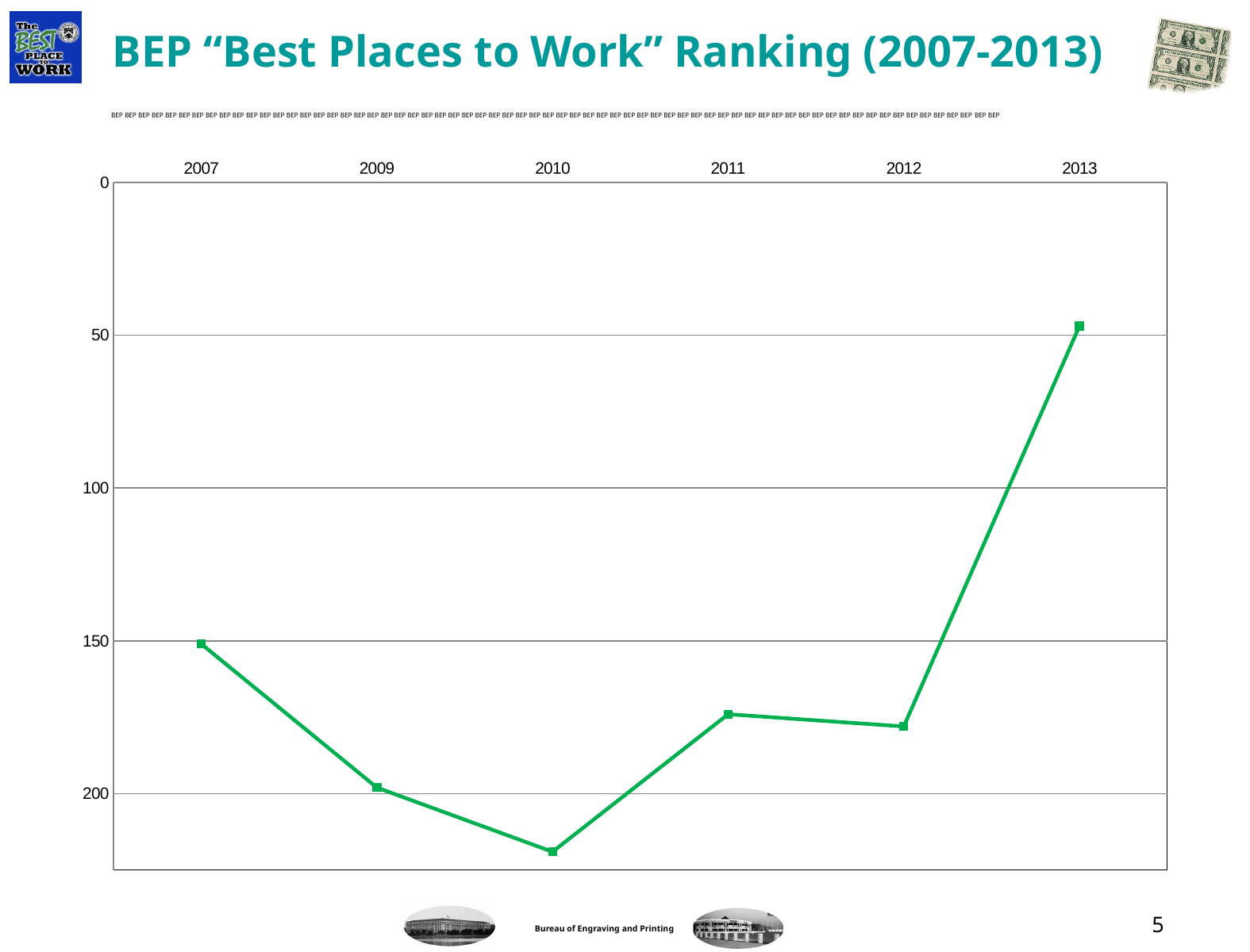
How many data points are plotted on the line? 6 Is the value for 2012 greater or less than 200? less Is the value for 2011 greater or less than 150? greater Is the value for 2010 greater or less than 200? greater What kind of chart is shown on the slide? line chart Do the plotted values rise or fall from 2007 to 2010? rise Which year has the smallest plotted value on the chart? 2013 Which year has the largest plotted value on the chart? 2010 What is the title of the chart on the slide? BEP "Best Places to Work" Ranking (2007-2013) Which year has the larger plotted value, 2007 or 2009? 2009